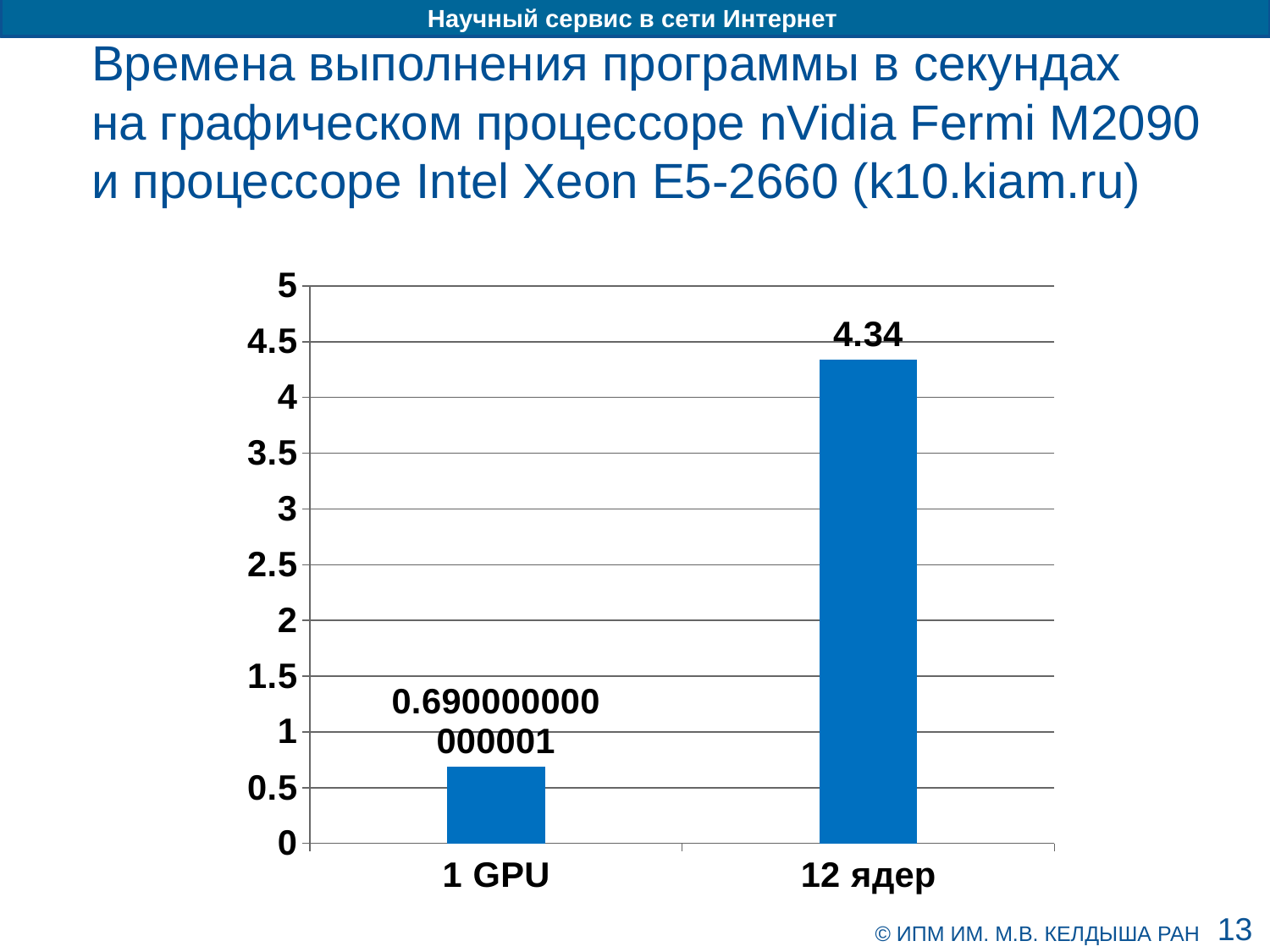
What kind of chart is shown on the slide? bar chart What is the value for 12 ядер? 4.34 What is the highest value shown on the y axis? 5 Is the value for 12 ядер greater or less than 4? greater Which category has the lowest value? 1 GPU How many categories are shown on the x axis? 2 Which is larger, the value for 1 GPU or the value for 12 ядер? 12 ядер Is the value for 12 ядер greater or less than 4.5? less Is the value for 1 GPU greater or less than 1? less Which category has the highest value? 12 ядер What colour are the bars in the chart? blue What is the value printed above the bar for 1 GPU? 0.690000000000001